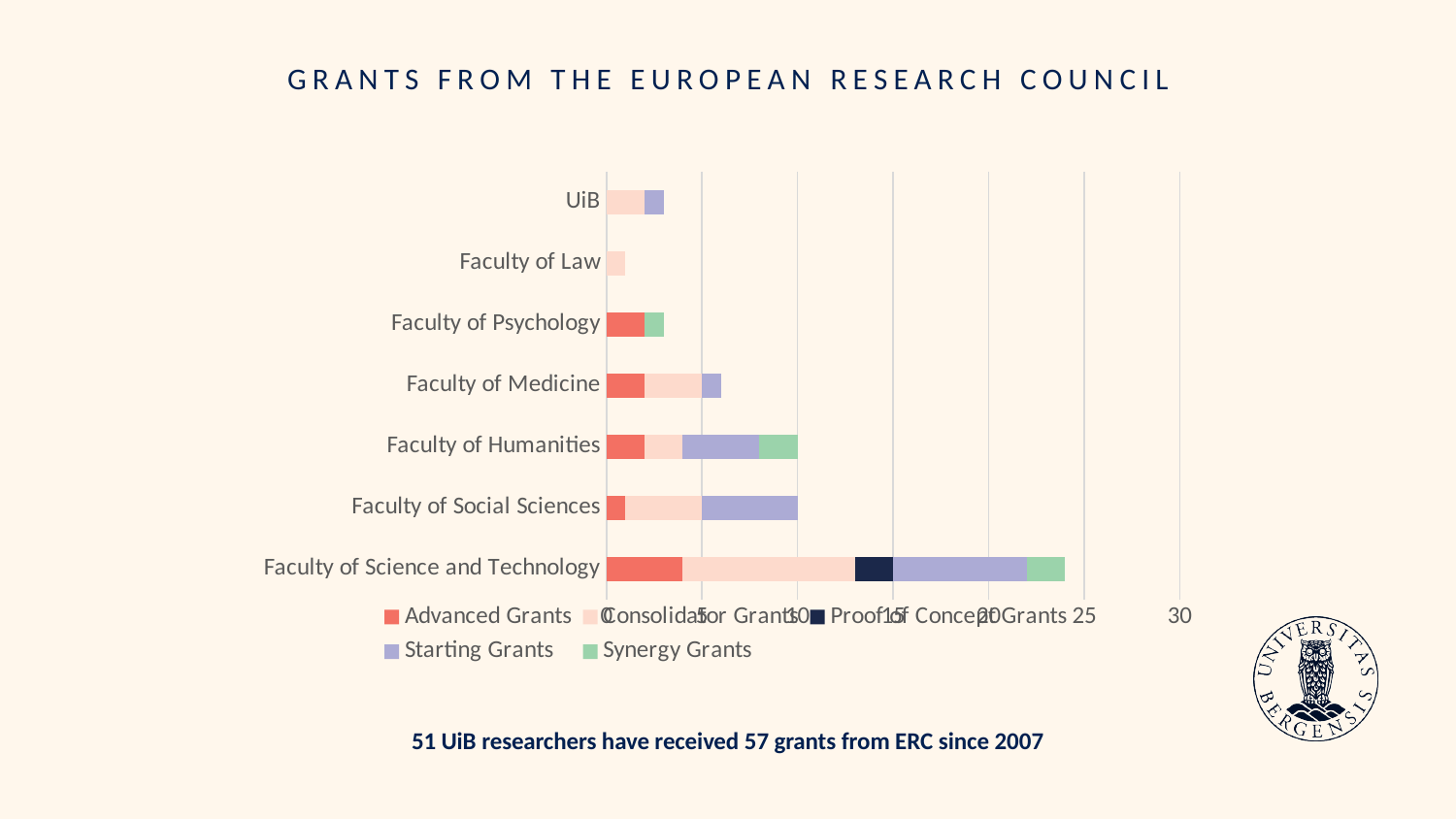
How many series does the legend list? 5 Which legend series is shown in dark navy? Proof of Concept Grants Which category has the longest total bar? Faculty of Science and Technology What is the title of the chart? GRANTS FROM THE EUROPEAN RESEARCH COUNCIL Is the total bar for Faculty of Medicine greater or less than 5? greater Which has the longer total bar, Faculty of Medicine or Faculty of Psychology? Faculty of Medicine Is the total bar for Faculty of Law greater or less than 5? less Which category has the shortest total bar? Faculty of Law Is the total bar for Faculty of Science and Technology greater or less than 20? greater What type of chart is shown on the slide? Stacked bar chart How many categories are plotted on the chart? 7